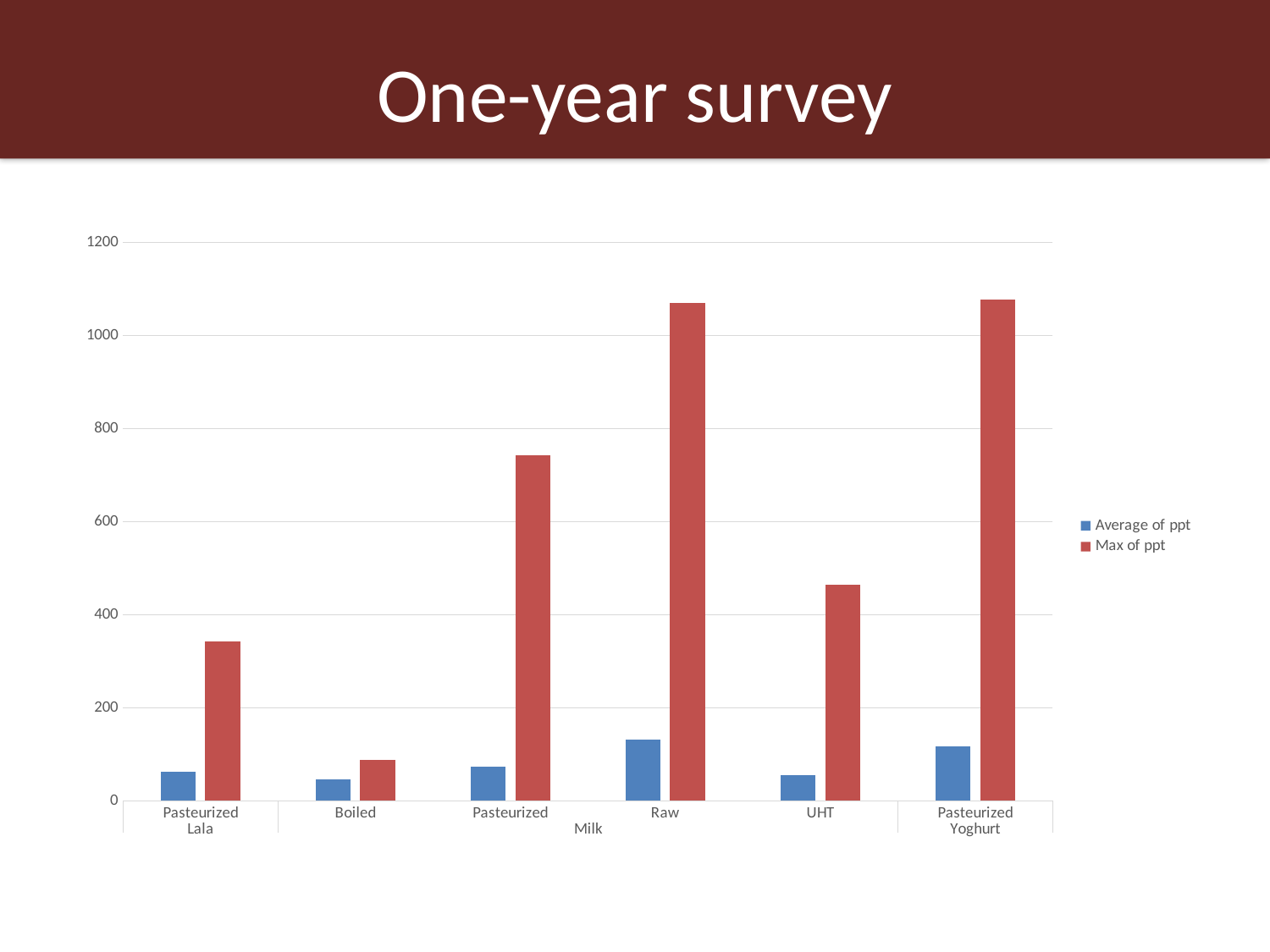
How many series does the legend list? 2 Which has the larger Max of ppt value, UHT or Pasteurized Lala? UHT Is the Max of ppt value for Pasteurized (under Milk) greater or less than 800? less Is the Max of ppt value for Boiled greater or less than 200? less Which category has the lowest Max of ppt value? Boiled Which colour represents the Max of ppt series in the legend? red Is the Average of ppt value for Raw greater or less than 200? less What is the title of the slide containing the chart? One-year survey How many categories are shown along the x axis? 6 What kind of chart is shown on the slide? bar chart